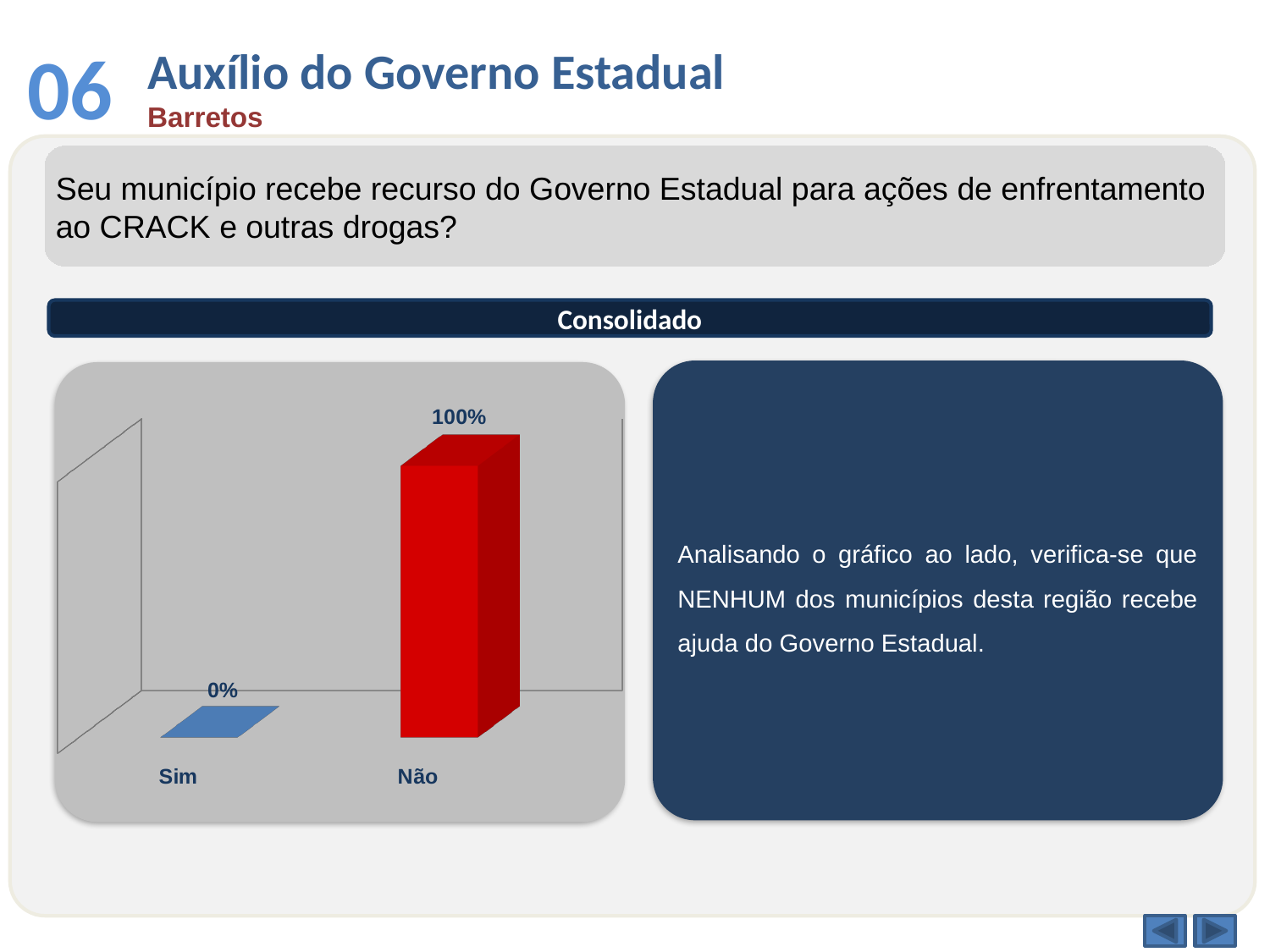
Which category has the highest value in the chart? Não What is the value for "Não" in the chart? 100% What kind of chart is shown on the slide? Bar chart Which is larger, the value for "Sim" or the value for "Não"? Não What is the value for "Sim" in the chart? 0% What is the difference between the values for "Não" and "Sim"? 100% How many categories are shown in the chart? 2 Which category has the lowest value in the chart? Sim What colour is the bar for "Sim"? Blue What colour is the bar for "Não"? Red